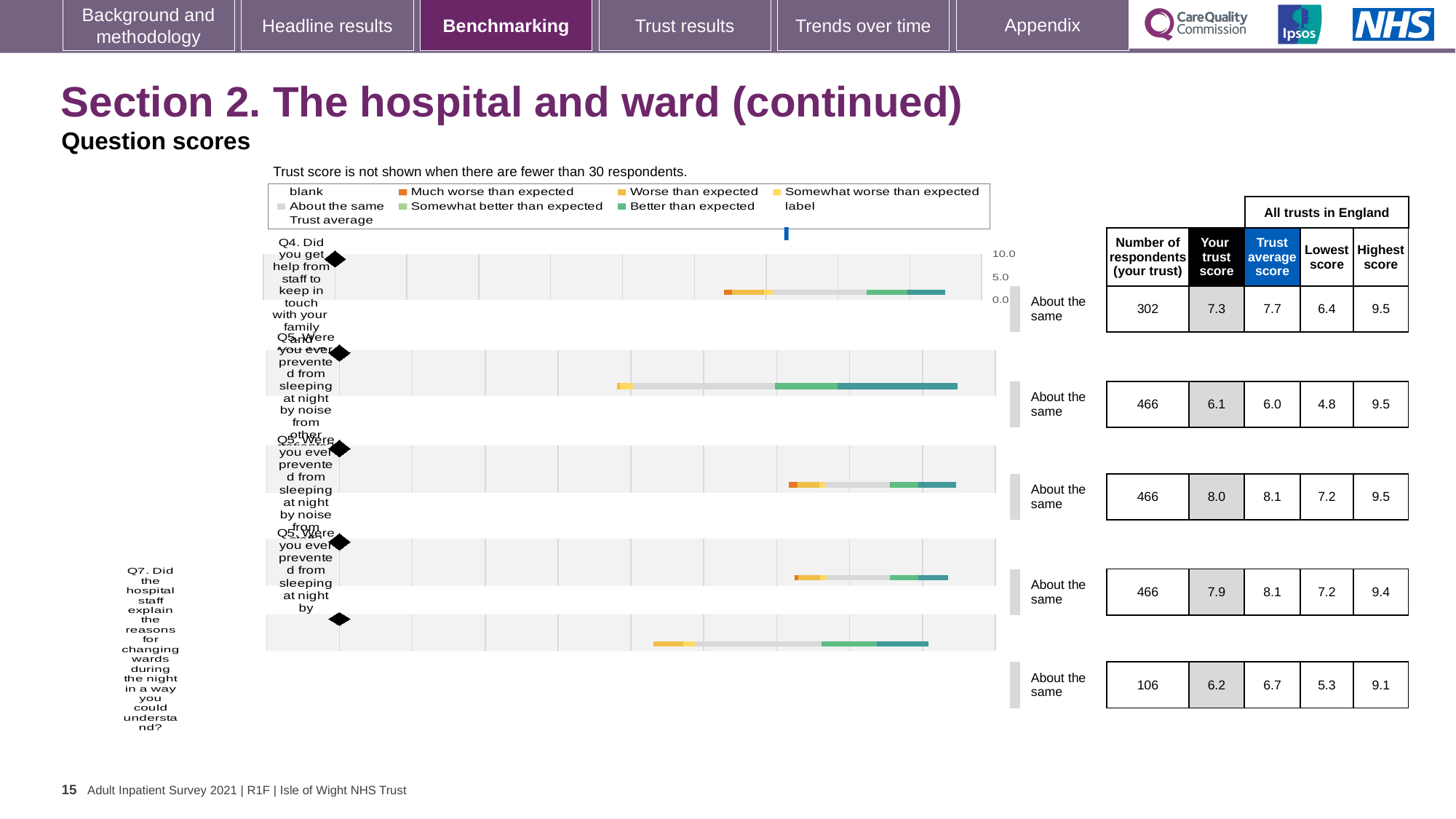
What benchmark category label is shown next to the Q4 bar? About the same What is the trust average score for Q4 (help from staff to keep in touch with family)? 7.7 How many respondents answered Q4 (help from staff to keep in touch with family)? 302 Which question row has the fewest respondents? Q7 What is the difference between the trust average score and the trust score for Q7? 0.5 What is the trust score for Q4 (help from staff to keep in touch with family)? 7.3 For Q4, which is larger: the trust score or the trust average score? trust average score (7.7) What is the difference between the highest score and the lowest score for Q4? 3.1 What kind of chart is used to show the question scores on this slide? bar chart How many respondents answered Q7 (explaining reasons for changing wards during the night)? 106 How many question rows (bars) are plotted in the chart? 5 What is the trust score for Q7 (explaining reasons for changing wards during the night)? 6.2